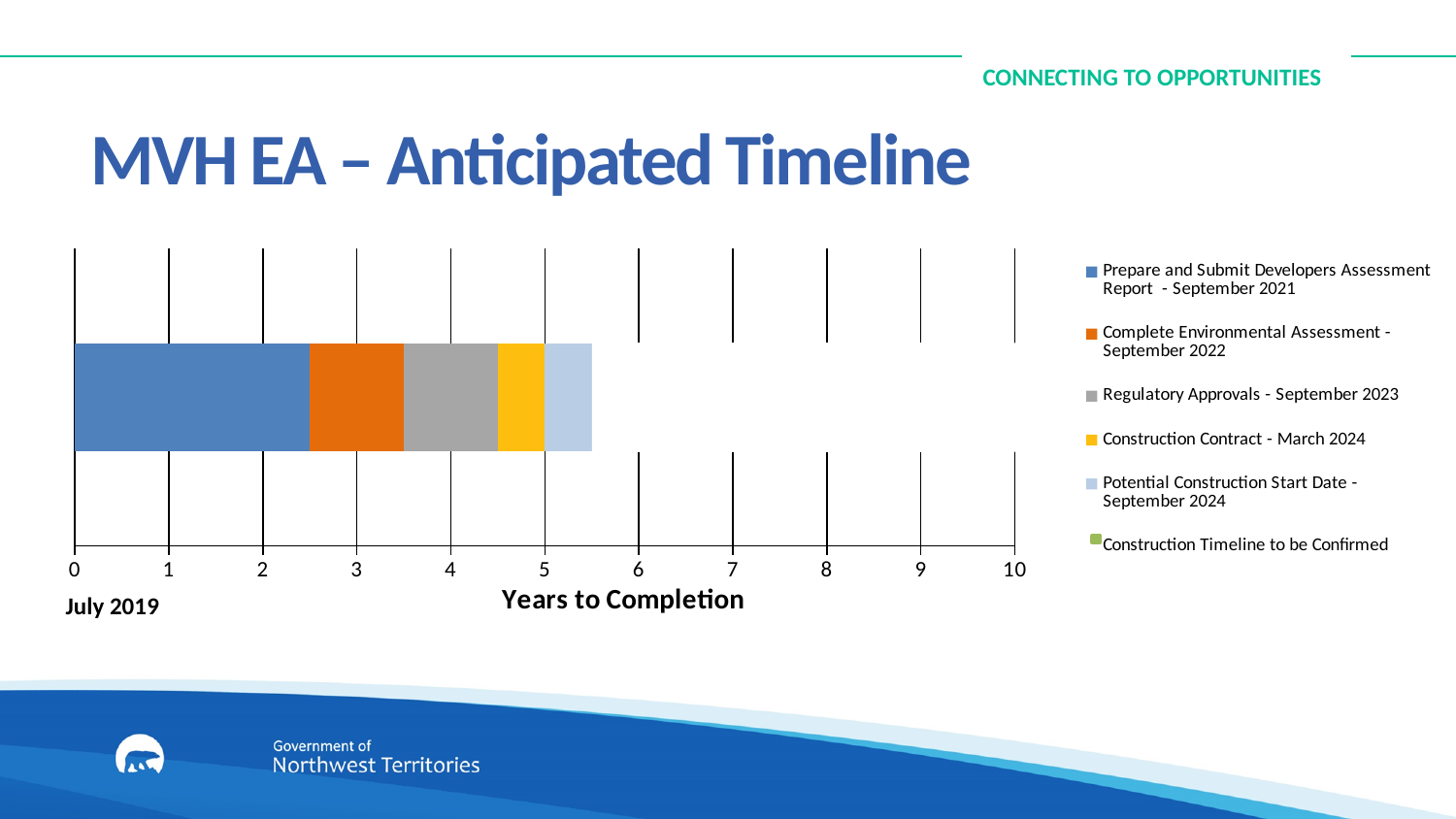
Is the length of the Prepare and Submit Developers Assessment Report segment greater or less than 3 years? less What kind of chart is shown on the slide? Stacked bar chart How many entries does the chart legend list? 6 What date label appears below the start of the horizontal axis? July 2019 Does the full stacked bar end at a value greater or less than 6 years? less What is the highest value shown on the horizontal axis? 10 How many stacked bars are plotted in the chart? 1 What is the title of the horizontal axis? Years to Completion Is the Prepare and Submit Developers Assessment Report segment longer or shorter than the Complete Environmental Assessment segment? longer Is the length of the Prepare and Submit Developers Assessment Report segment greater or less than 2 years? greater Which segment of the bar is the longest? Prepare and Submit Developers Assessment Report - September 2021